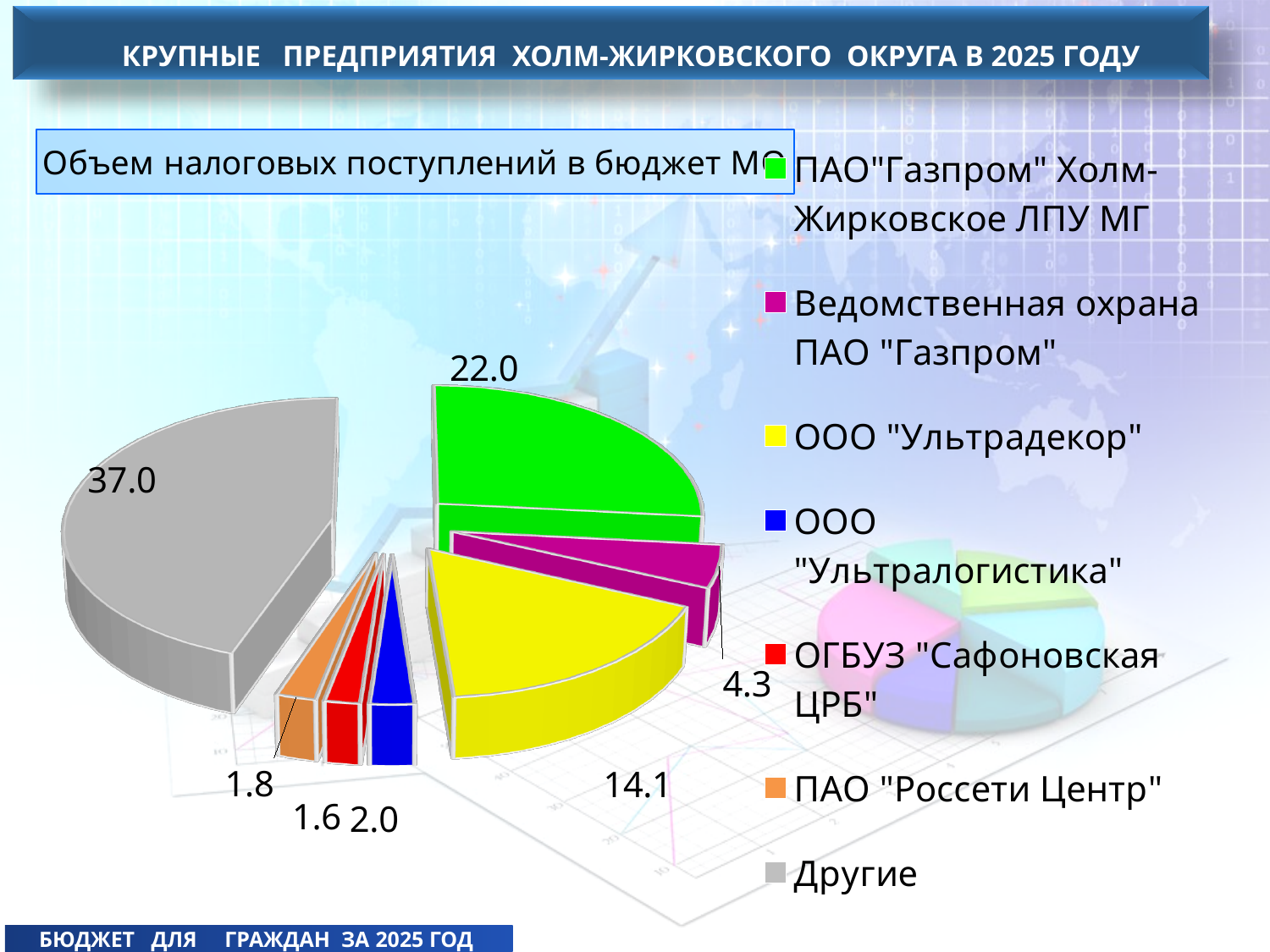
What is the value for ООО "Ультрадекор"? 14.1 How many categories does the pie chart have? 7 What colour is the slice for ООО "Ультрадекор"? Yellow What is the difference between the values for ПАО "Газпром" Холм-Жирковское ЛПУ МГ and ООО "Ультрадекор"? 7.9 Which category has the smallest value? ОГБУЗ "Сафоновская ЦРБ" What is the value for Ведомственная охрана ПАО "Газпром"? 4.3 What type of chart is shown on the slide? Pie chart Which category has the largest value? Другие What is the value for ПАО "Газпром" Холм-Жирковское ЛПУ МГ? 22.0 What is the value for ОГБУЗ "Сафоновская ЦРБ"? 1.6 What is the difference between the values for Другие and ПАО "Газпром" Холм-Жирковское ЛПУ МГ? 15.0 Which is larger: the value for ООО "Ультралогистика" or the value for ПАО "Россети Центр"? ООО "Ультралогистика"